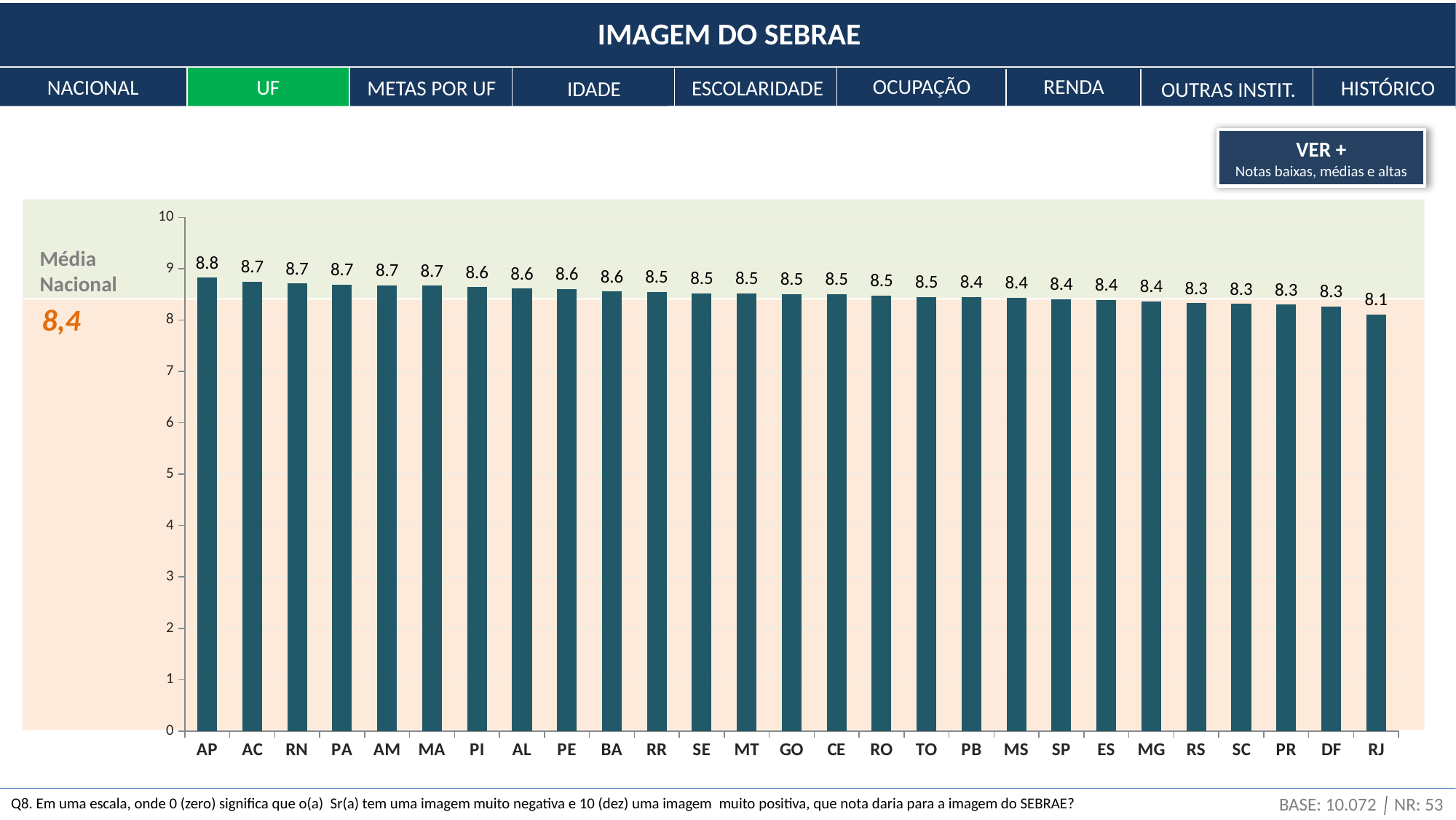
Which is larger, the value for AC or the value for DF? AC What is the value for SP? 8.4 Is the value for MG greater or less than 5? greater What is the value for PI? 8.6 What is the value for RJ? 8.1 Which category has the highest value? AP How many categories (UFs) are shown on the x axis? 27 What is the value for AP? 8.8 What kind of chart is shown on the slide? bar chart What is the national average (Média Nacional) shown on the slide? 8,4 Which category has the lowest value? RJ What is the difference between the values for AP and RJ? 0.7